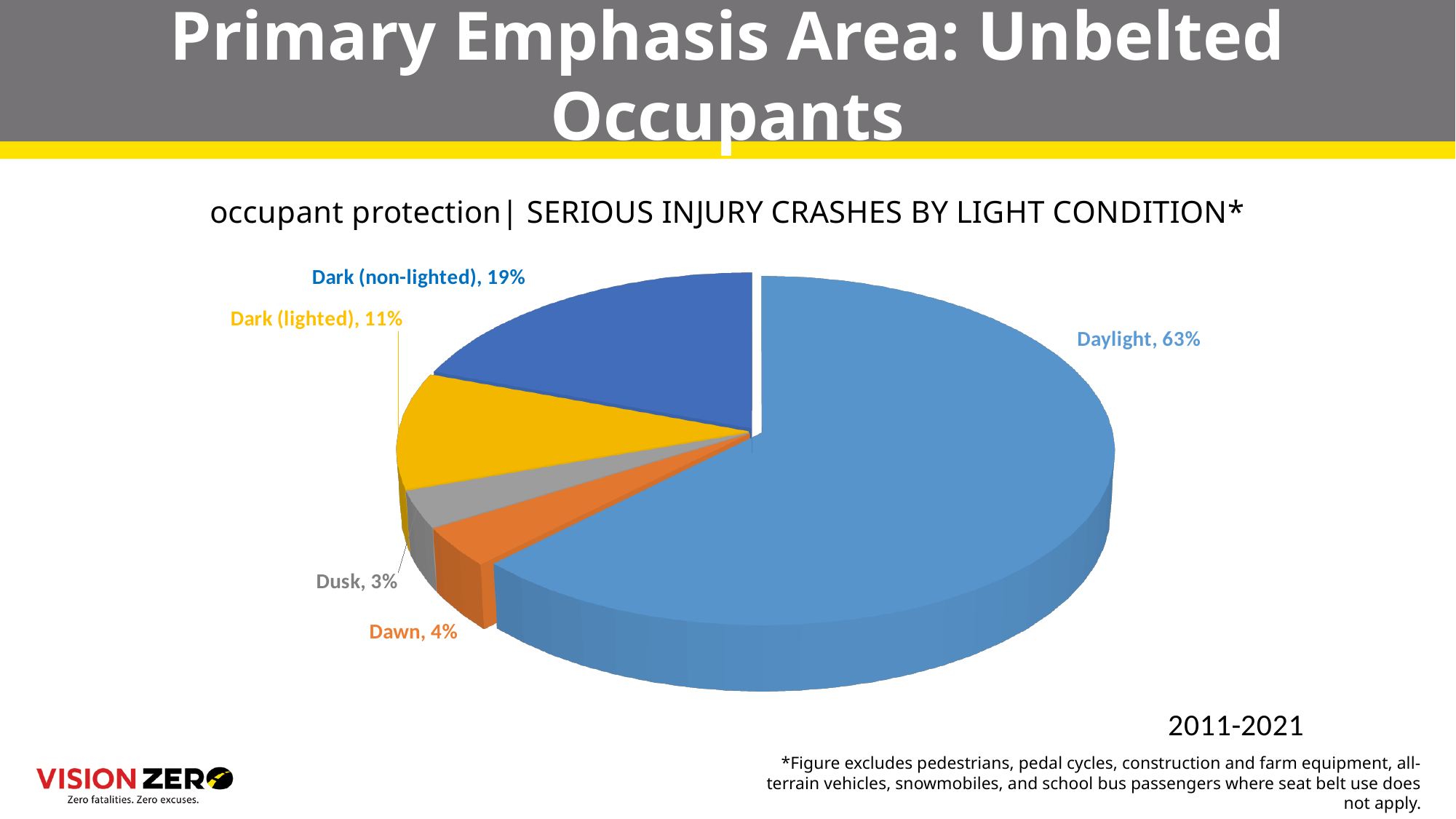
Which light condition has the smallest share of serious injury crashes? Dusk What share of serious injury crashes occurred at Dusk? 3% What is the title of the chart? occupant protection| SERIOUS INJURY CRASHES BY LIGHT CONDITION* What share of serious injury crashes occurred in Dark (non-lighted) conditions? 19% How many light condition categories are shown in the pie chart? 5 Which has a larger share, Dark (lighted) or Dawn? Dark (lighted) What share of serious injury crashes occurred at Dawn? 4% What share of serious injury crashes occurred in Daylight? 63% What is the difference in percentage points between Daylight and Dark (non-lighted)? 44 What share of serious injury crashes occurred in Dark (lighted) conditions? 11% What type of chart is shown on the slide? Pie chart Which light condition has the largest share of serious injury crashes? Daylight